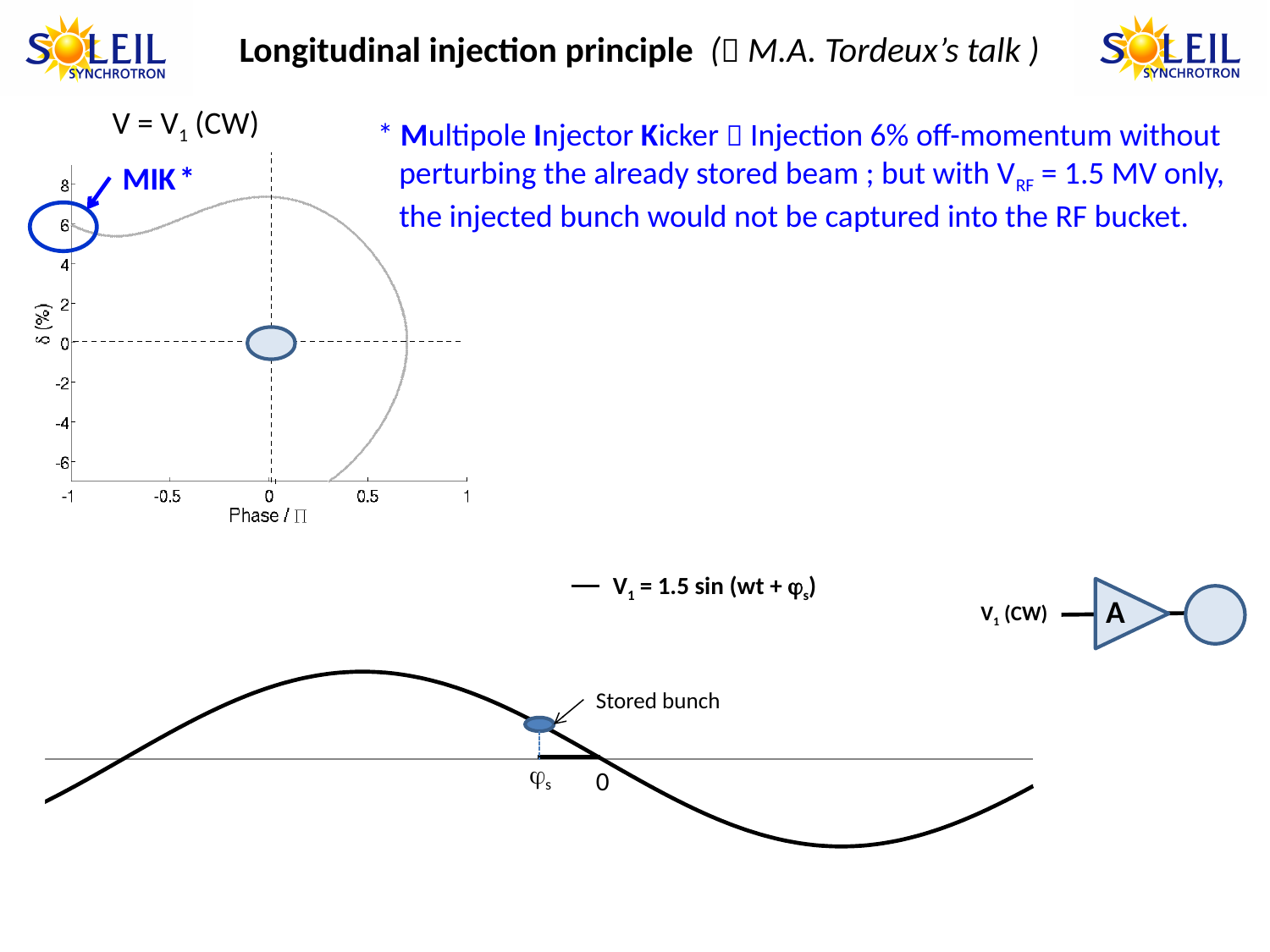
In the phase-space plot at the top left, which has the larger δ value, the injected bunch marked MIK or the stored bunch? the injected bunch marked MIK In the phase-space plot at the top left, is the phase of the injected bunch marked MIK greater or less than -0.5? less In the phase-space plot at the top left, what is the label of the vertical axis? δ (%) What is the amplitude of V1 in the equation shown in the legend of the lower plot? 1.5 In the phase-space plot at the top left, at what phase value is the stored bunch centred? 0 In the phase-space plot at the top left, at what δ value is the stored bunch centred? 0 How many series does the legend of the lower sine-wave plot list? 1 In the phase-space plot at the top left, what is the label of the horizontal axis? Phase / π According to the text on the slide, by what percentage off-momentum is the bunch injected with the MIK? 6% In the phase-space plot at the top left, is the δ value of the injected bunch marked MIK greater or less than 4? greater What kind of chart is the lower plot showing V1 = 1.5 sin (wt + φs)? line chart In the lower sine-wave plot, does the curve rise or fall as it passes through the stored bunch position moving to the right? fall